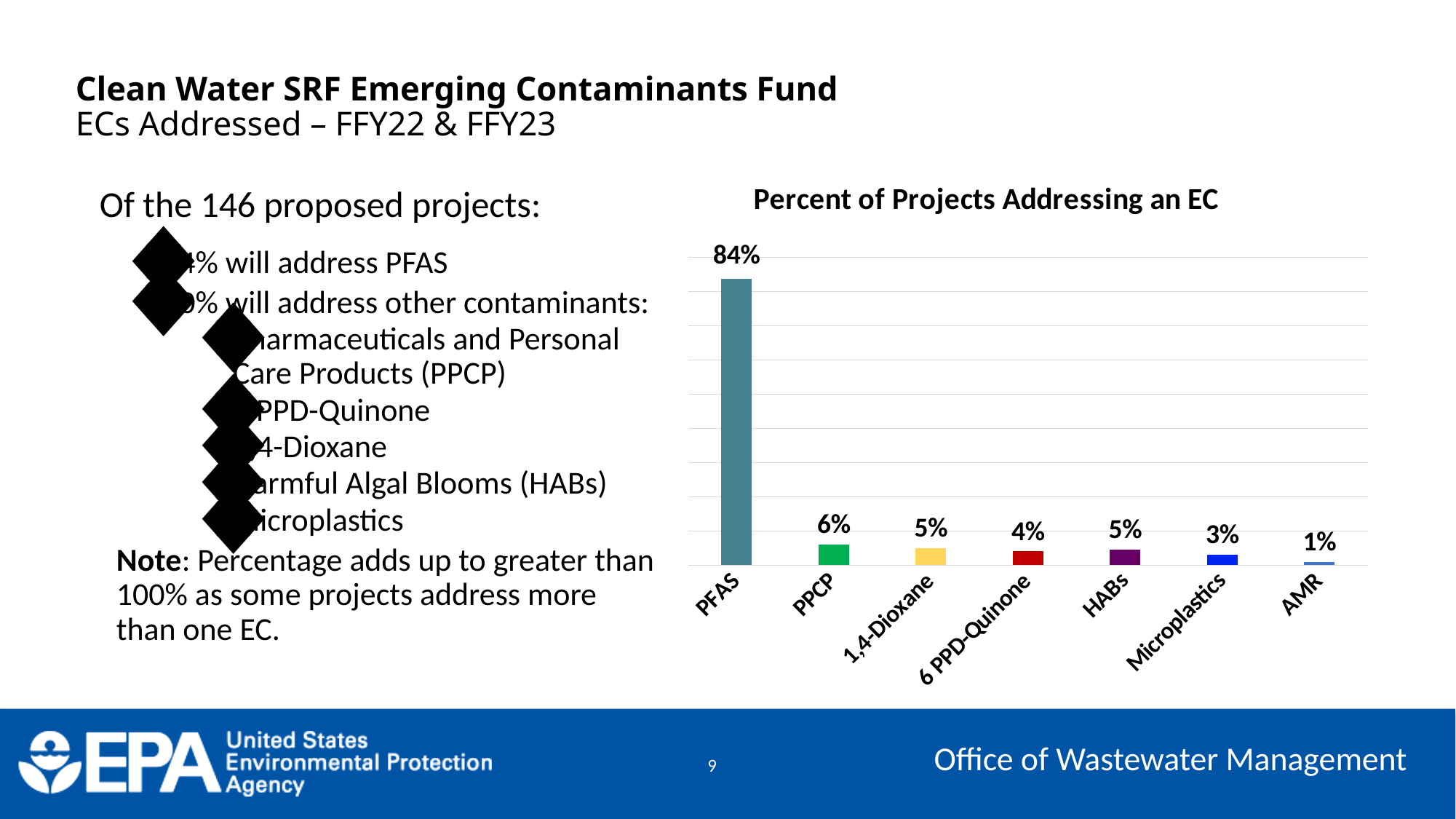
What percent of projects address PFAS according to the chart? 84% Which is larger, the value for PPCP or the value for 6 PPD-Quinone? PPCP What is the value shown for PPCP in the chart? 6% What kind of chart is shown on the slide? Bar chart Which category has the highest value in the chart? PFAS What is the value shown for AMR? 1% What is the title of the chart? Percent of Projects Addressing an EC What is the difference between the values for HABs and Microplastics? 2% Which category has the lowest value in the chart? AMR What is the difference between the values for PFAS and PPCP? 78% What percent of projects address Microplastics? 3% How many categories are shown on the x axis of the chart? 7